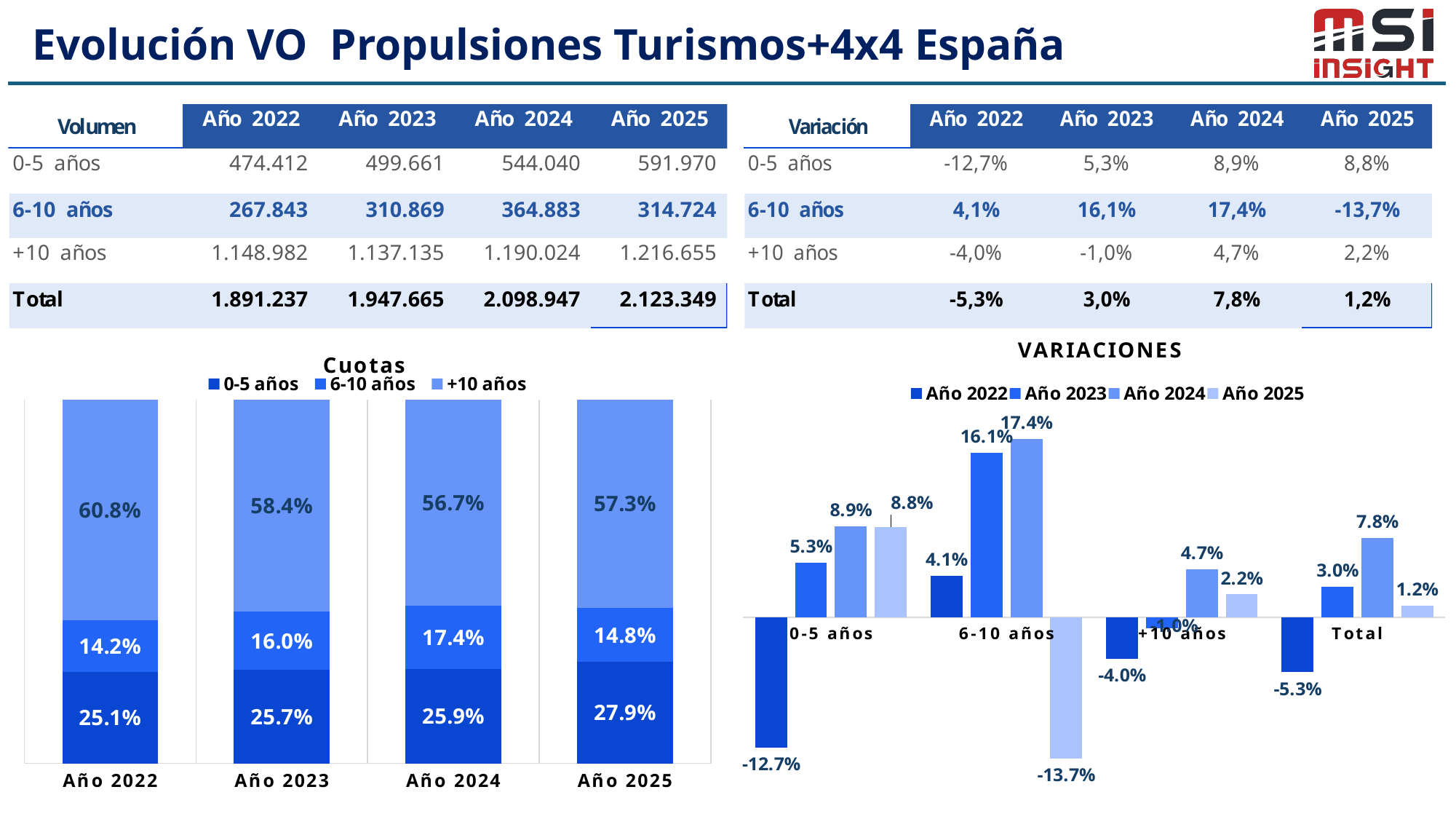
What type of chart is the VARIACIONES chart? bar chart In the Cuotas chart, what is the share of 6-10 años in Año 2024? 17.4% In the Cuotas chart, what is the difference between the +10 años share in Año 2022 and Año 2025? 3.5% In the VARIACIONES chart, what is the value for 6-10 años in Año 2024? 17.4% In the VARIACIONES chart, what is the value for Total in Año 2022? -5.3% In the VARIACIONES chart, which category has the lowest value in Año 2025? 6-10 años In the Cuotas chart, what is the share of +10 años in Año 2022? 60.8% In the VARIACIONES chart, which is larger for 0-5 años: Año 2023 or Año 2024? Año 2024 In the Cuotas chart, does the +10 años share rise or fall from Año 2022 to Año 2024? fall In the Cuotas chart, which year has the highest share for 0-5 años? Año 2025 In the Cuotas chart, what is the share of 0-5 años in Año 2025? 27.9% In the Cuotas chart, how many series does the legend list? 3